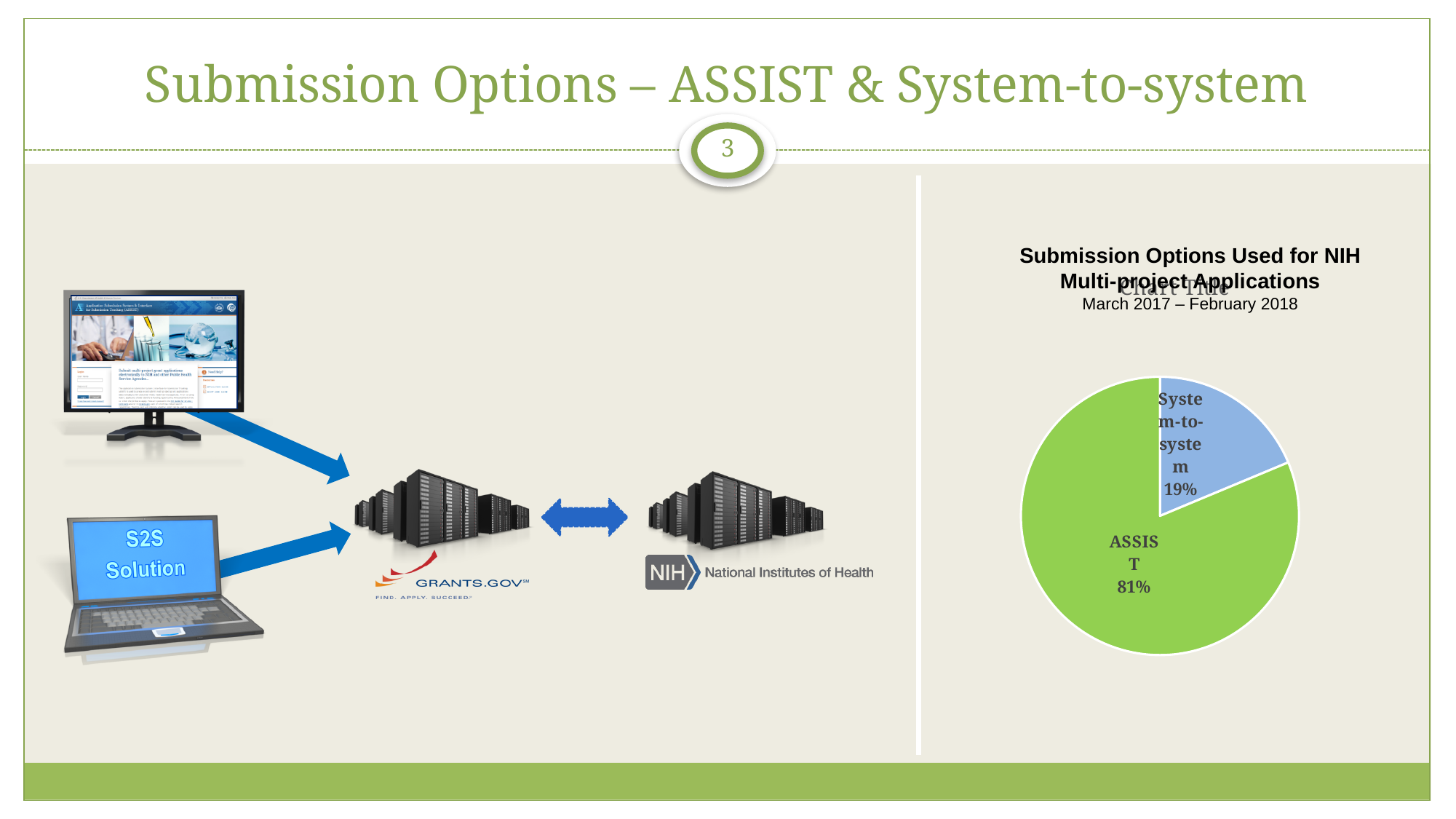
What kind of chart is shown on the slide? pie chart What share of the pie does System-to-system represent? 19% Which submission option has the largest share of the pie? ASSIST What is the difference in percentage points between the ASSIST share and the System-to-system share? 62 How many slices does the pie chart have? 2 Which submission option has the smallest share of the pie? System-to-system What time period does the pie chart cover, according to its title? March 2017 – February 2018 Which is larger, the share for ASSIST or the share for System-to-system? ASSIST What colour is the ASSIST slice of the pie chart? green What share of the pie does ASSIST represent? 81%